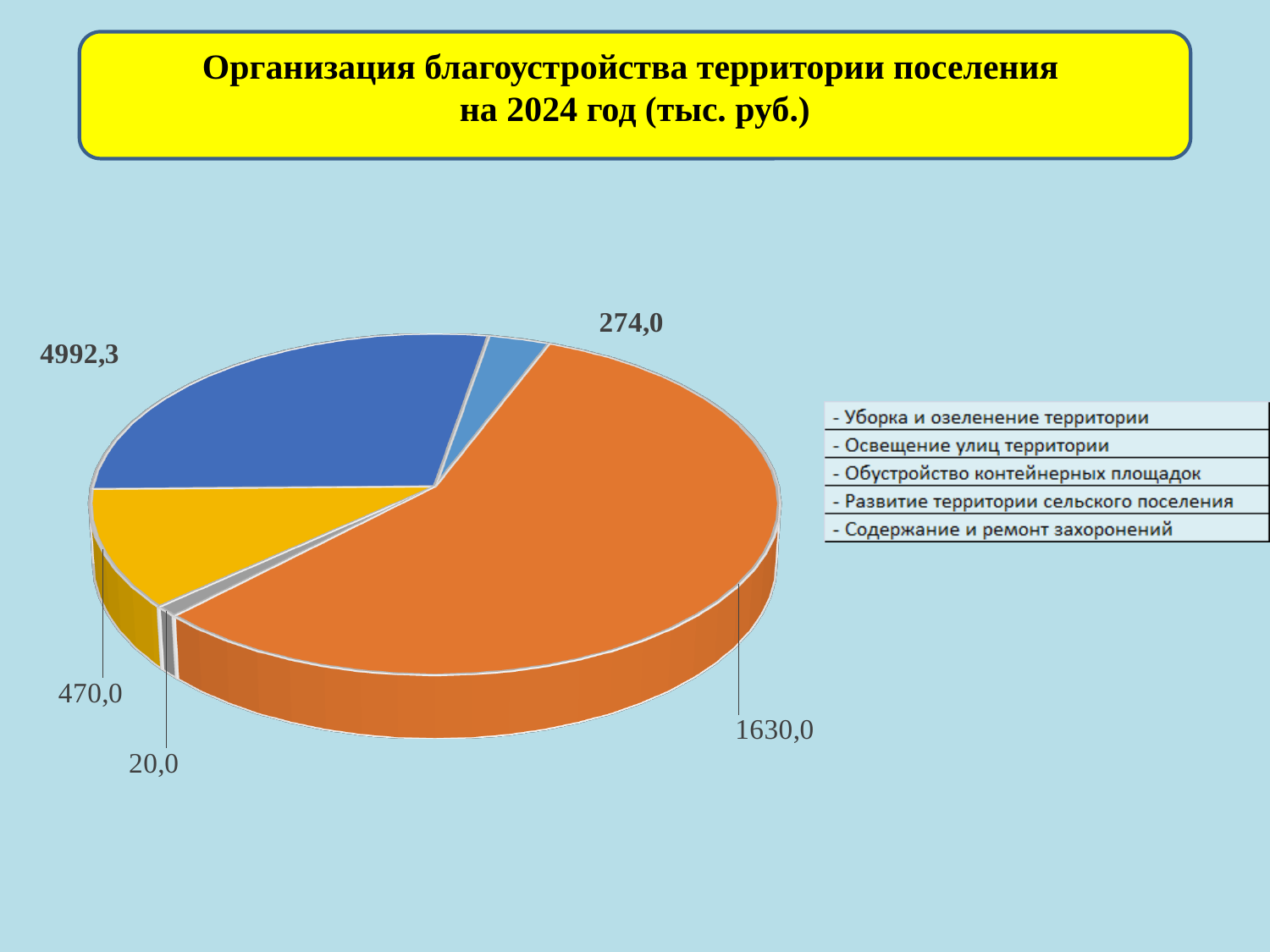
How many entries does the legend list? 5 What is the difference between the largest labelled value (4992,3) and the second largest (1630,0)? 3362,3 Which labelled value is larger, 470,0 or 274,0? 470,0 What is the total of all the values labelled on the pie chart? 7386,3 What is the first entry listed in the legend? Уборка и озеленение территории What is the smallest value labelled on the pie chart? 20,0 What kind of chart is shown on the slide? pie chart What unit is stated in the chart title for the values? тыс. руб. What is the largest value labelled on the pie chart? 4992,3 What is the title of the slide containing the pie chart? Организация благоустройства территории поселения на 2024 год (тыс. руб.) What is the difference between the labelled values 470,0 and 274,0? 196,0 How many slices does the pie chart have? 5